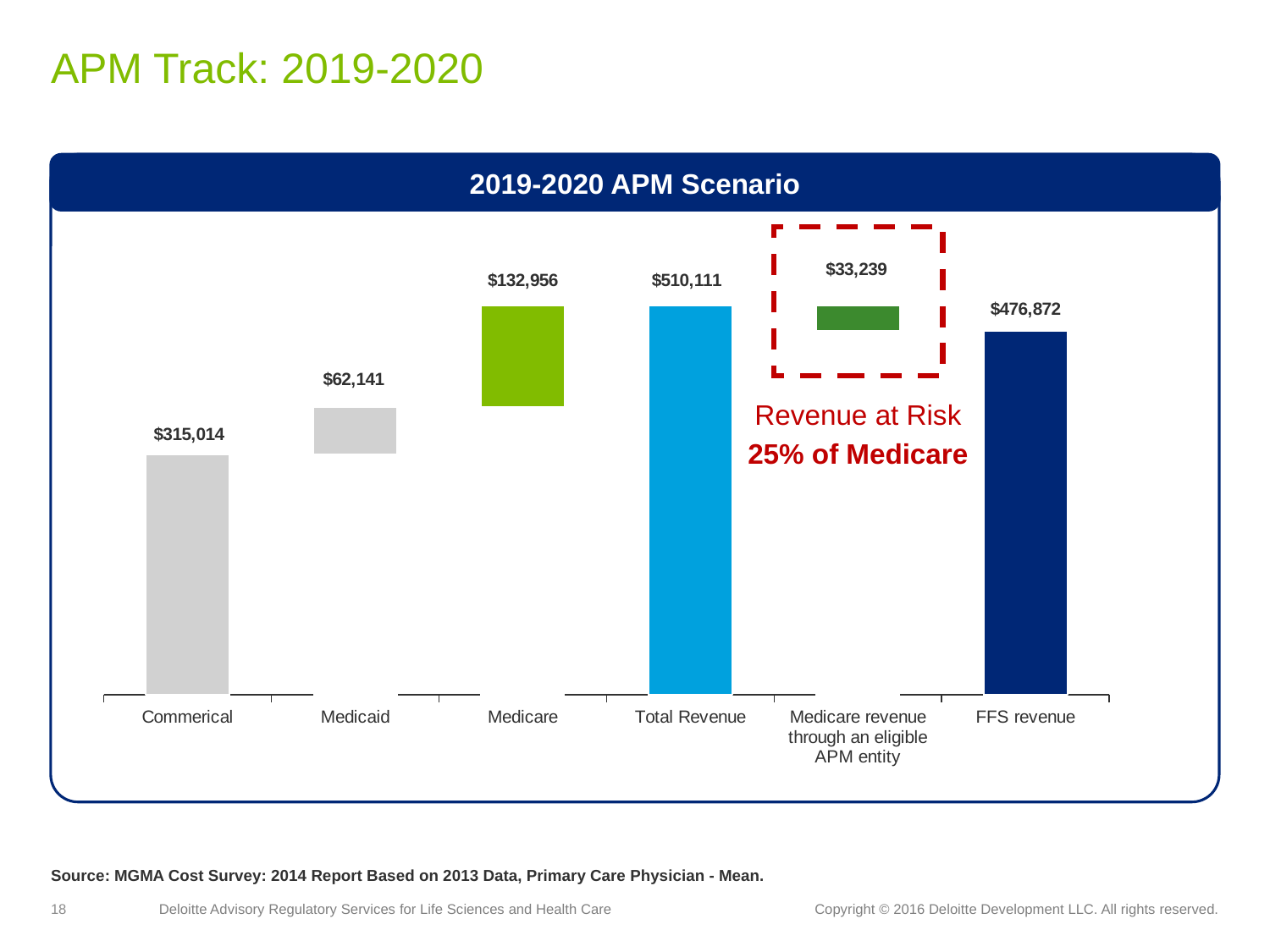
What is the value for Medicaid? $62,141 What is the value for Medicare revenue through an eligible APM entity? $33,239 What is the value for Commerical in the 2019-2020 APM Scenario chart? $315,014 Which category has the highest value? Total Revenue What is the title of the chart? 2019-2020 APM Scenario What is the value for Medicare? $132,956 What is the value for FFS revenue? $476,872 Which category has the lowest value? Medicare revenue through an eligible APM entity How many categories are shown on the x axis? 6 What is the value for Total Revenue? $510,111 What is the difference between Total Revenue and FFS revenue? $33,239 Which is larger, Commerical or Medicare? Commerical